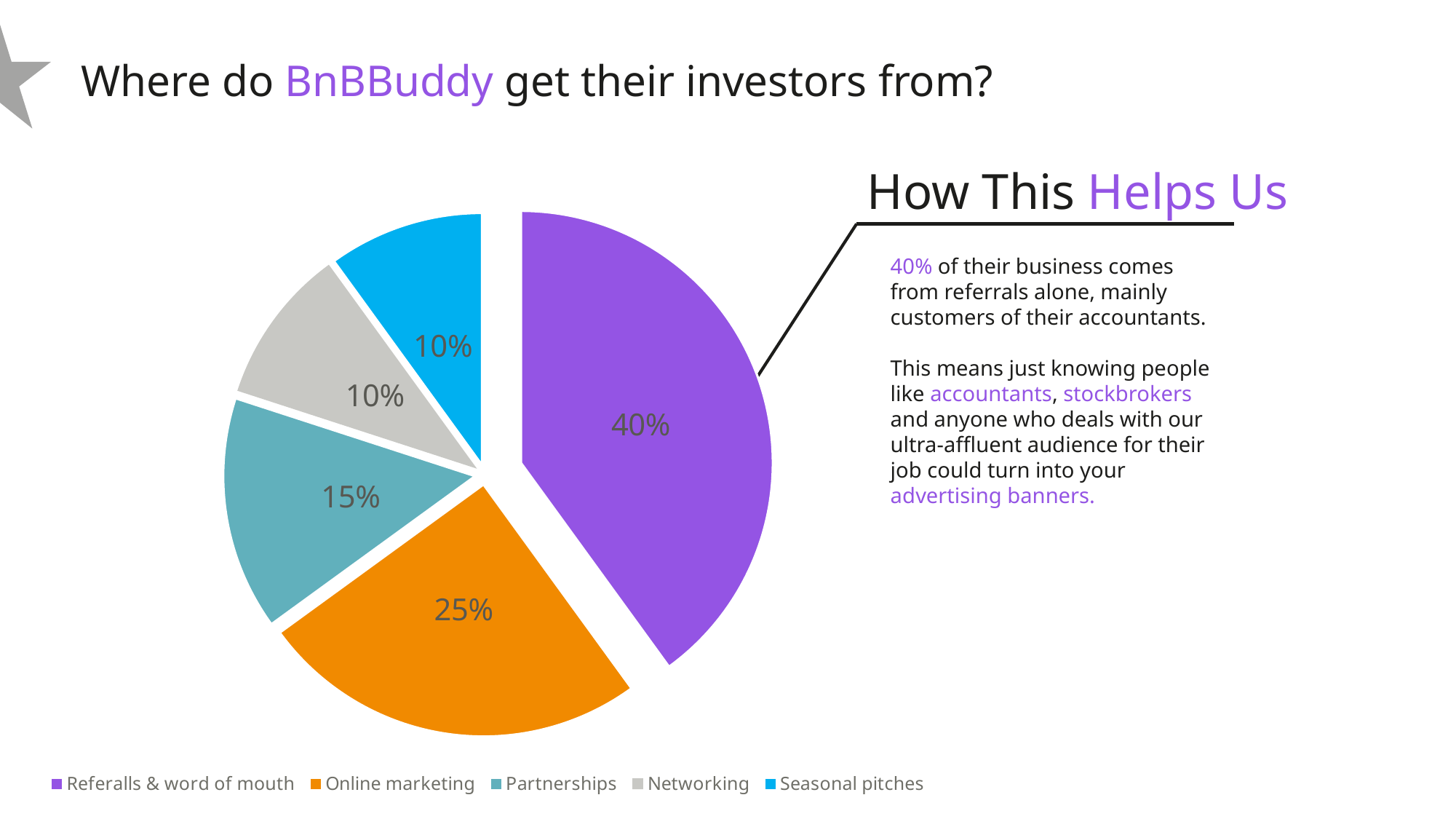
How many categories does the pie chart have? 5 What share of the pie does Referalls & word of mouth have? 40% What is the value for Online marketing? 25% What is the difference between the Online marketing slice and the Partnerships slice? 10% What is the value for Networking? 10% How many entries does the legend list? 5 Which is larger, Partnerships or Seasonal pitches? Partnerships What is the value for Partnerships? 15% Which category has the largest slice of the pie? Referalls & word of mouth What kind of chart is shown on the slide? Pie chart What is the difference between the Referalls & word of mouth slice and the Online marketing slice? 15% What colour is the Online marketing slice? Orange